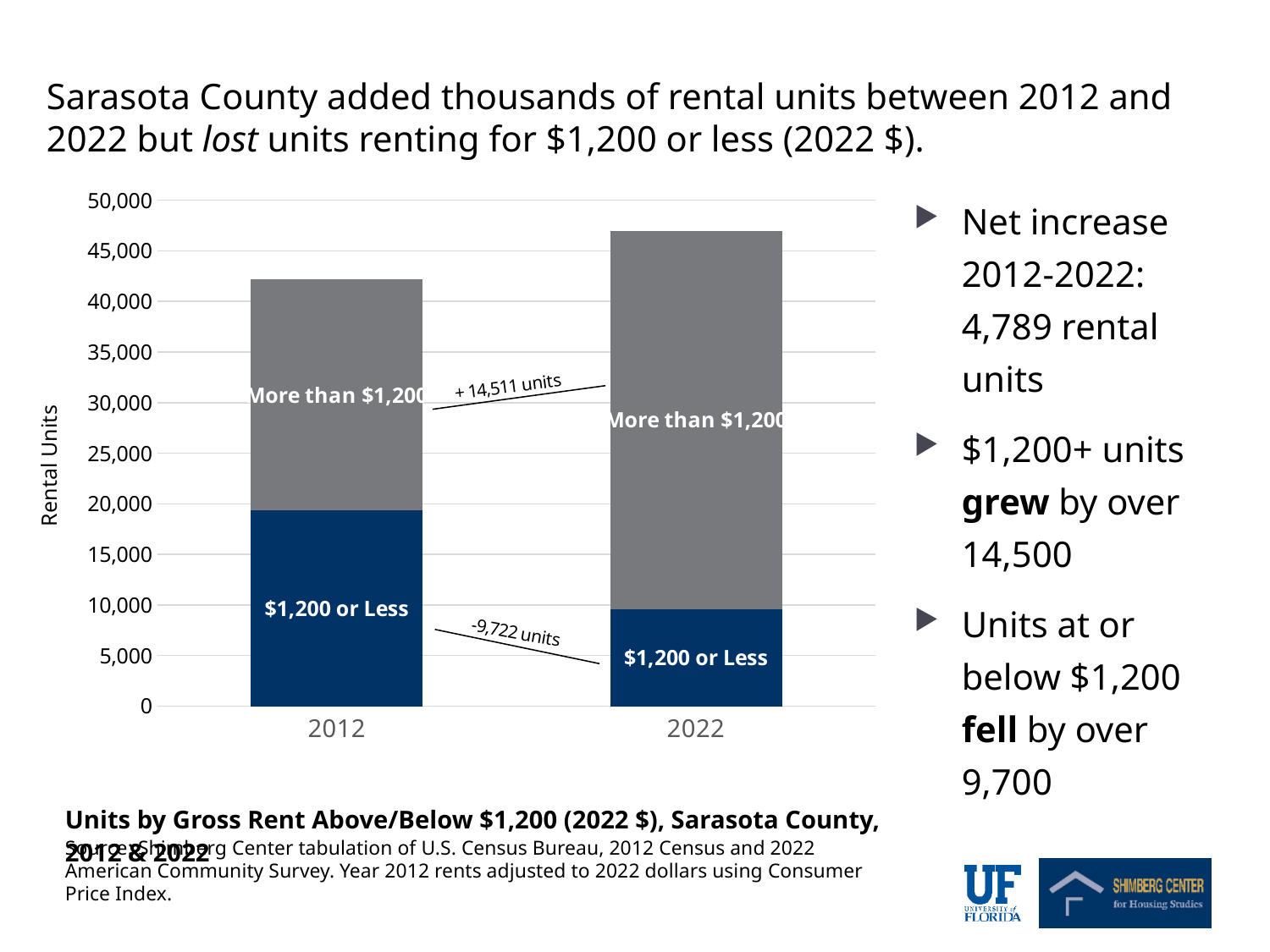
Which year has the larger '$1,200 or Less' segment, 2012 or 2022? 2012 Does the '$1,200 or Less' segment rise or fall from 2012 to 2022? Fall What kind of chart is shown on the slide? Stacked bar chart How many years (categories) are shown on the x axis of the chart? 2 Is the '$1,200 or Less' value for 2022 greater or less than 15,000? less Which year has the taller total bar in the chart, 2012 or 2022? 2022 According to the annotation on the chart, by how many units did the '$1,200 or Less' segment change between 2012 and 2022? -9,722 units Is the '$1,200 or Less' value for 2012 greater or less than 15,000? greater According to the annotation on the chart, by how many units did the 'More than $1,200' segment change between 2012 and 2022? + 14,511 units How many rent segments is each bar in the chart divided into? 2 Is the total height of the 2022 bar greater or less than 45,000? greater What is the label on the vertical axis of the chart? Rental Units